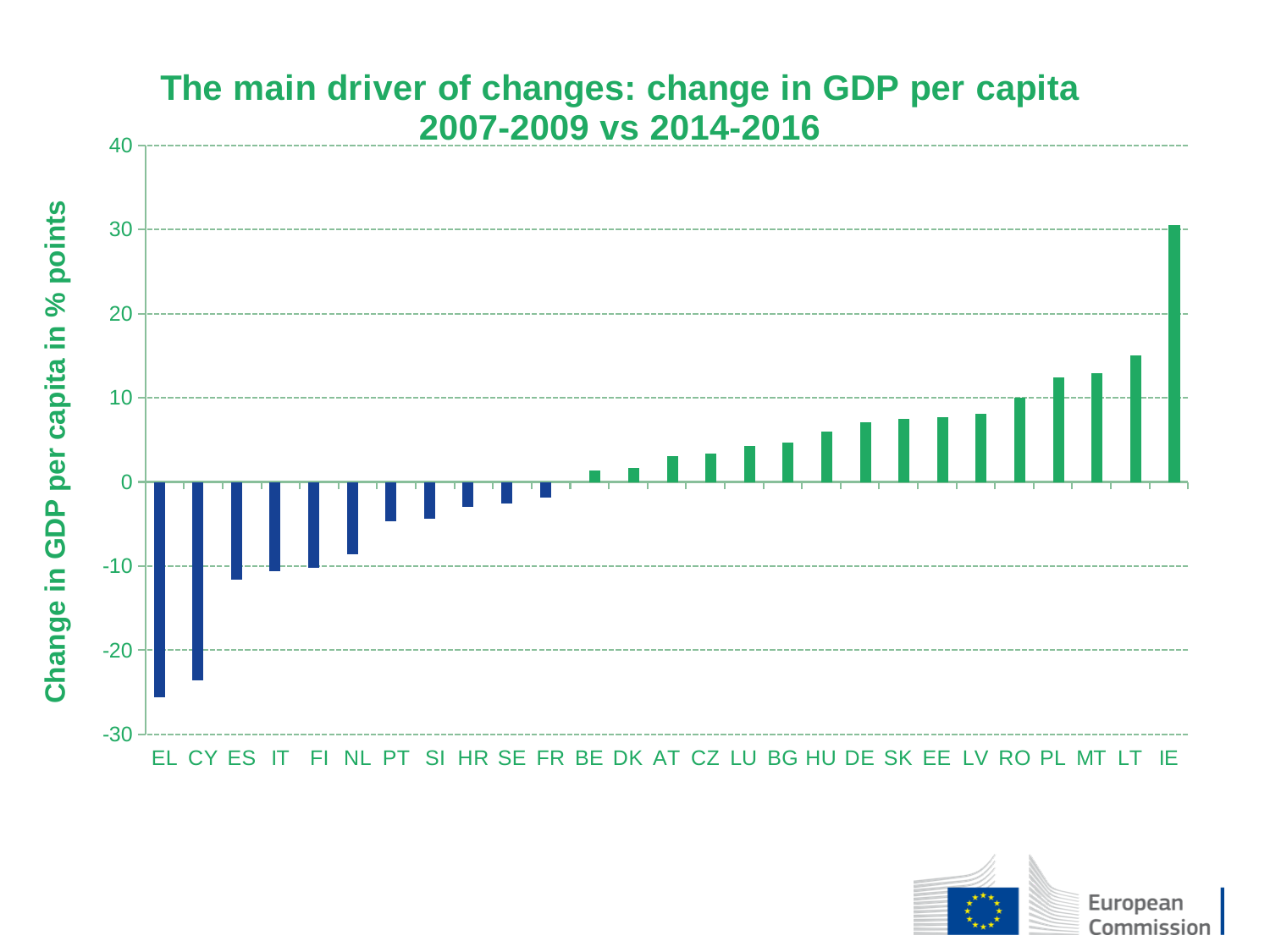
Is the value for IE greater or less than 20? greater Which country has the lowest change in GDP per capita? EL Is the value for LT greater or less than 10? greater Do the values rise or fall moving from left to right along the x axis? rise How many countries are shown on the x axis? 27 Which has the larger value, IE or LT? IE Which country has the highest change in GDP per capita? IE What kind of chart is shown on the slide? bar chart What colour are the bars with negative values? blue Is the value for CY greater or less than -20? less